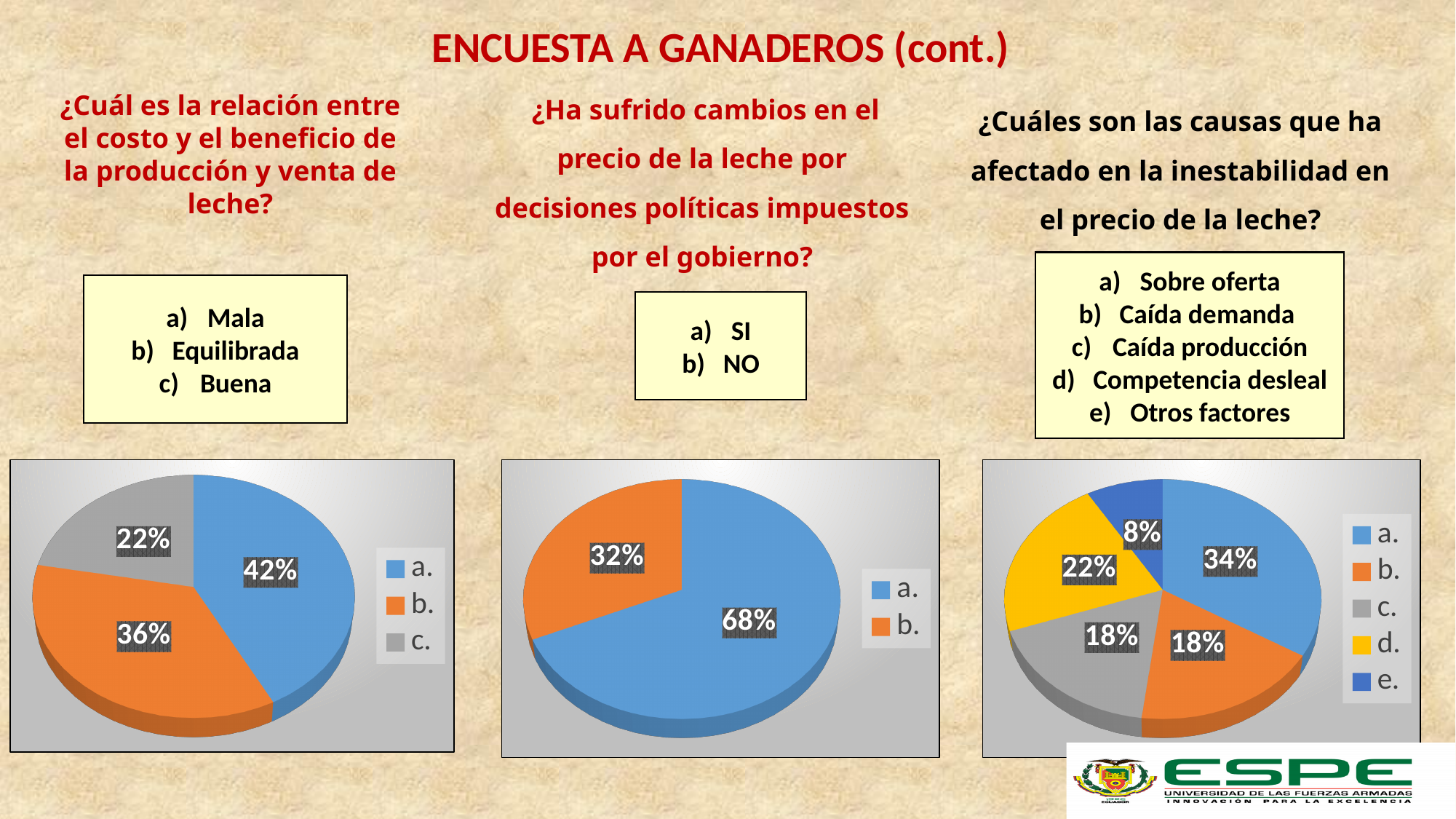
What type of chart is the left chart? Pie chart How many slices does the right pie chart have? 5 In the left pie chart, what percentage is shown for slice a.? 42% In the right pie chart, which slice is the smallest? e. In the middle pie chart, which slice is larger, a. or b.? a. In the right pie chart, what percentage is shown for slice d.? 22% In the left pie chart, what is the difference between slice a. and slice b.? 6% How many series does the legend of the middle pie chart list? 2 In the left pie chart, what percentage is shown for slice c.? 22% In the left pie chart, which slice is the largest? a. In the middle pie chart, what percentage is shown for slice b.? 32% In the right pie chart, what is the difference between slice a. and slice e.? 26%